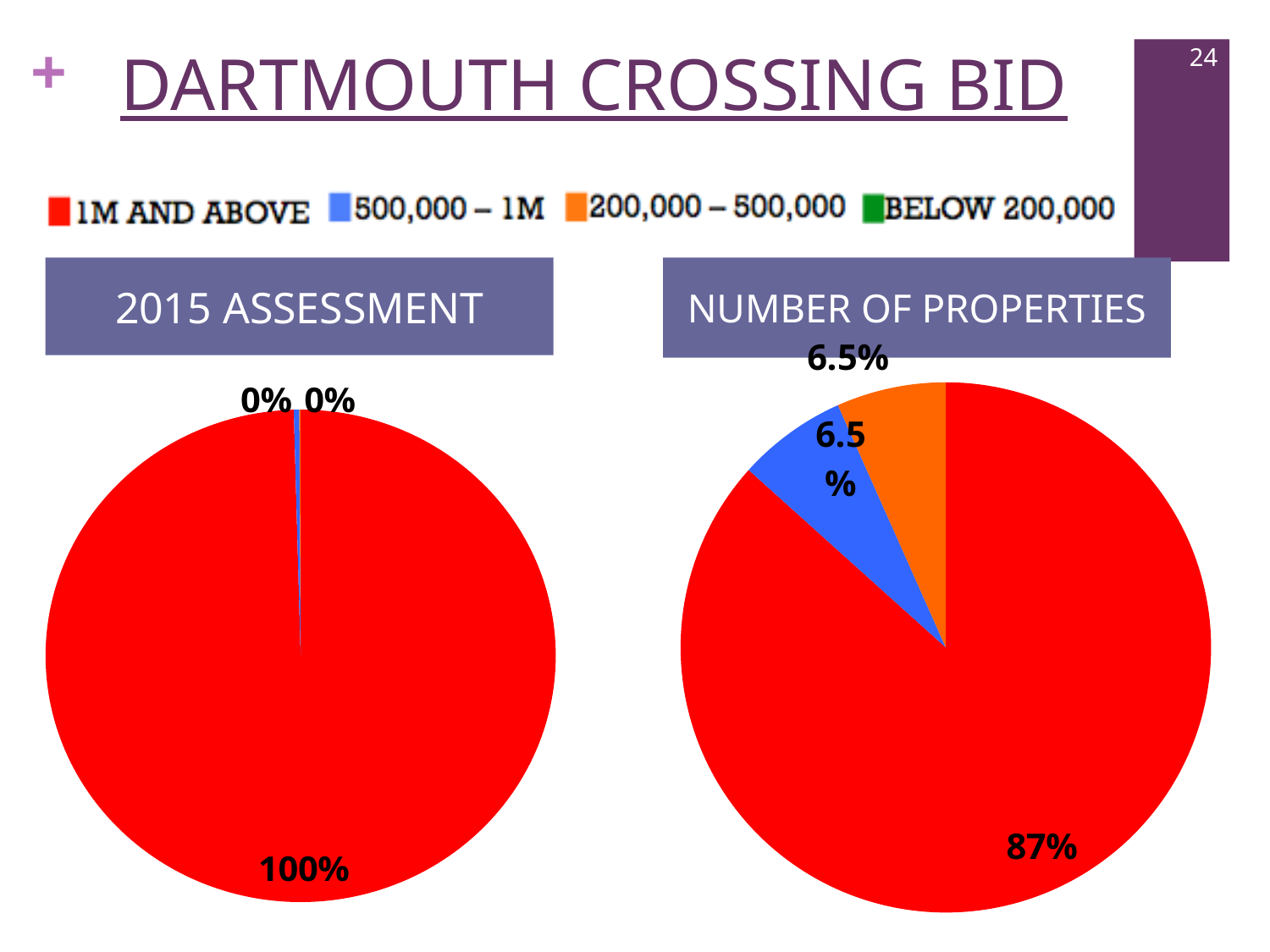
What is the title of the chart on the right side of the slide? NUMBER OF PROPERTIES In the NUMBER OF PROPERTIES chart, what share does the 200,000 – 500,000 category have? 6.5% How many categories does the legend list? 4 In the NUMBER OF PROPERTIES chart, what share does the 1M AND ABOVE category have? 87% In the 2015 ASSESSMENT chart, which category has the largest slice? 1M AND ABOVE In the NUMBER OF PROPERTIES chart, what share does the 500,000 – 1M category have? 6.5% What kind of charts are shown on the slide? Pie charts Which colour represents the 500,000 – 1M category in the legend? Blue In the NUMBER OF PROPERTIES chart, which category has the largest slice? 1M AND ABOVE In the NUMBER OF PROPERTIES chart, is the 1M AND ABOVE share larger or smaller than the 200,000 – 500,000 share? Larger In the NUMBER OF PROPERTIES chart, what is the difference between the 1M AND ABOVE share and the 500,000 – 1M share? 80.5%